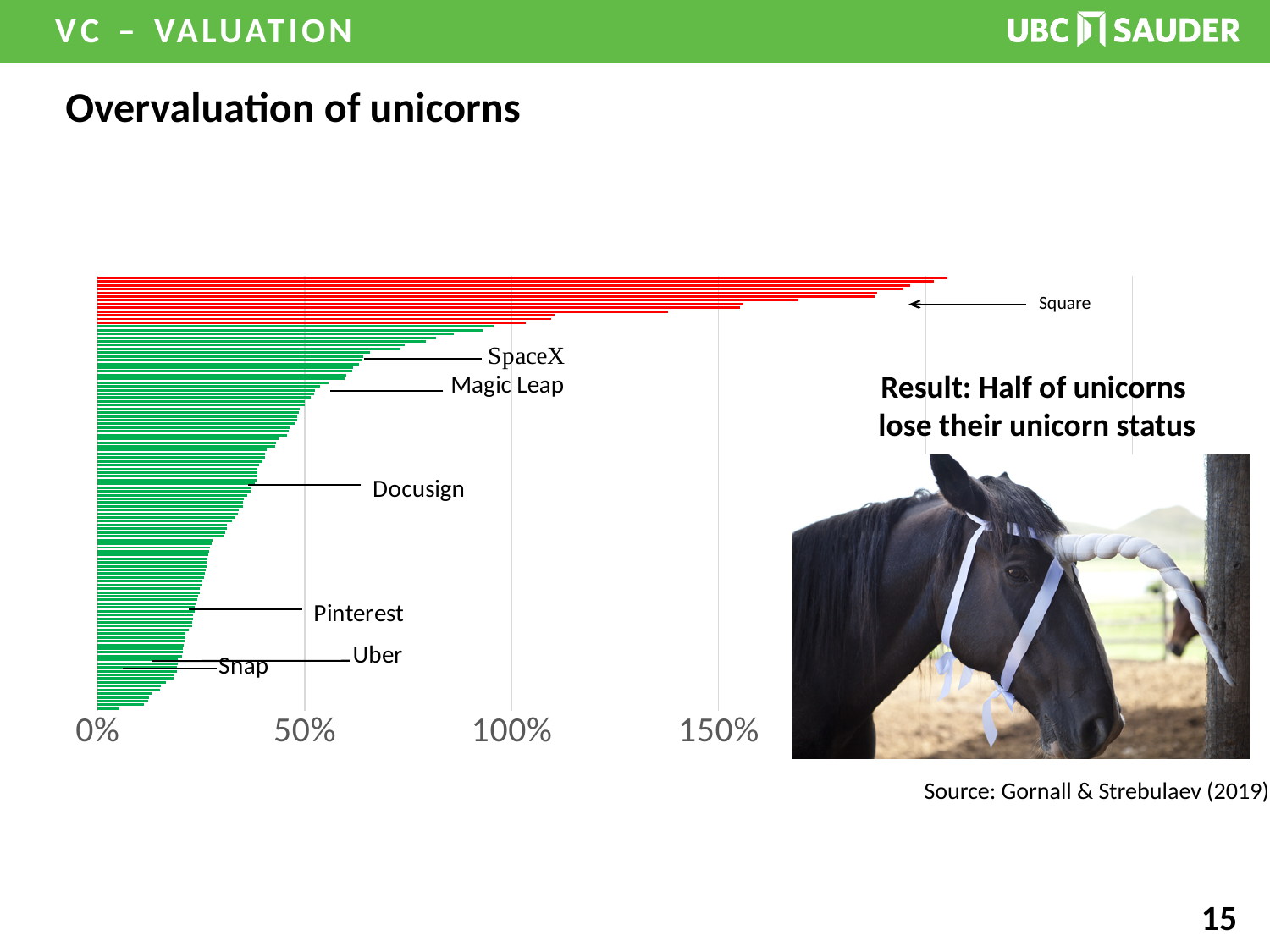
Is the value for Square greater or less than 150%? greater Which has the larger value, Square or Snap? Square Which has the larger value, SpaceX or Docusign? SpaceX What is the title of the chart on the slide? Overvaluation of unicorns Is the value for SpaceX greater or less than 50%? greater What kind of chart is shown on the slide? bar chart Is the value for Snap greater or less than 50%? less What two colours are used for the bars in the chart? red and green Which has the larger value, Docusign or Uber? Docusign